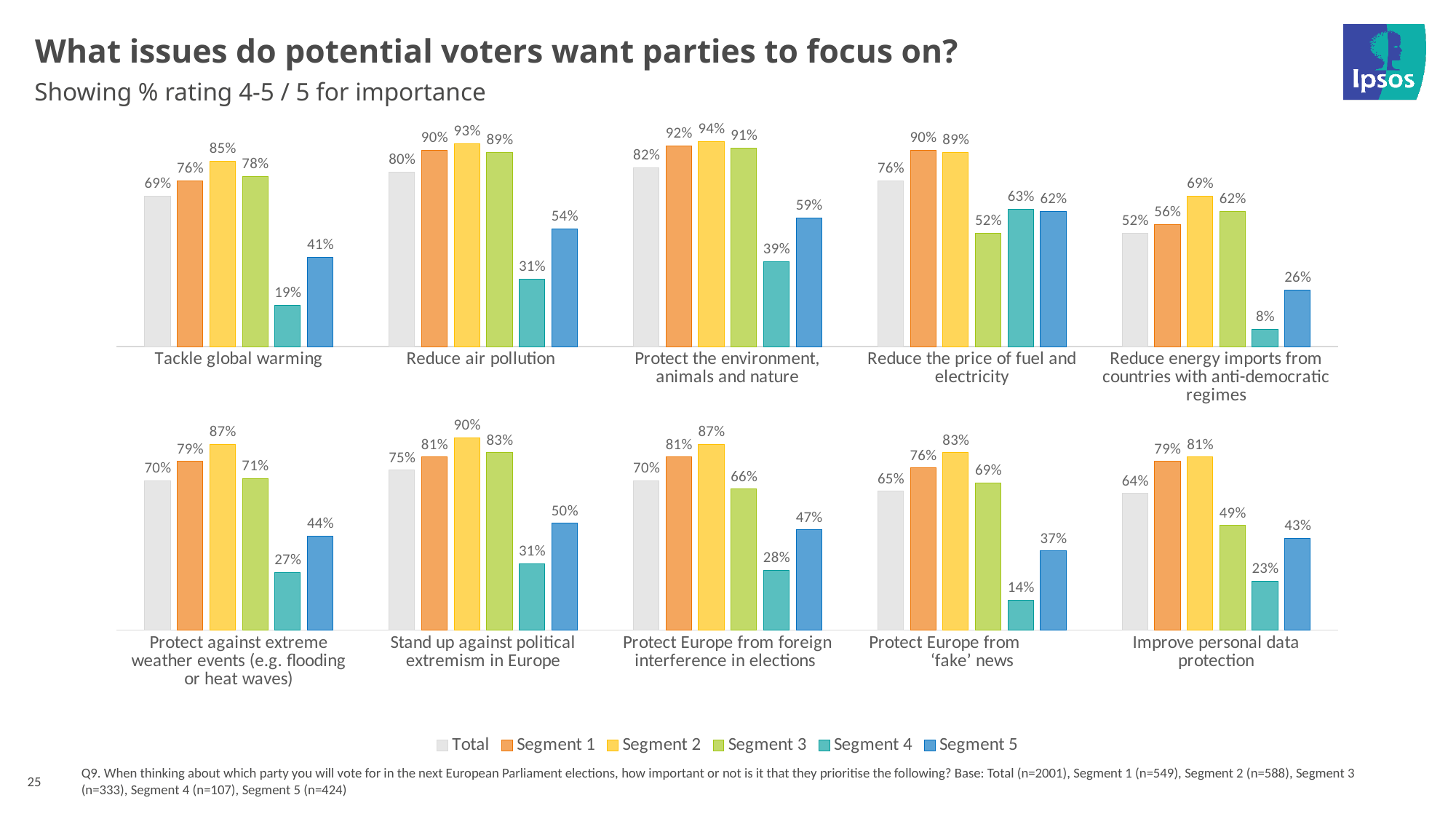
In the top chart, what is the value for Segment 2 for 'Tackle global warming'? 85% In the bottom chart, what is the value for Segment 4 for 'Protect Europe from ‘fake’ news'? 14% In the top chart, what is the difference between Segment 3 and Segment 5 for 'Reduce the price of fuel and electricity'? 10 percentage points In the top chart, what is the Total value for 'Reduce energy imports from countries with anti-democratic regimes'? 52% How many series does the legend list? 6 Which colour represents Segment 4 in the legend? Teal In the top chart, what is the difference between Segment 2 and Segment 4 for 'Reduce air pollution'? 62 percentage points In the bottom chart, which is larger for 'Improve personal data protection': Segment 3 or Segment 5? Segment 3 How many issue categories are shown in the bottom chart? 5 In the bottom chart, which segment has the highest value for 'Stand up against political extremism in Europe'? Segment 2 What kind of chart is used on this slide? Bar chart In the top chart, which segment has the lowest value for 'Protect the environment, animals and nature'? Segment 4